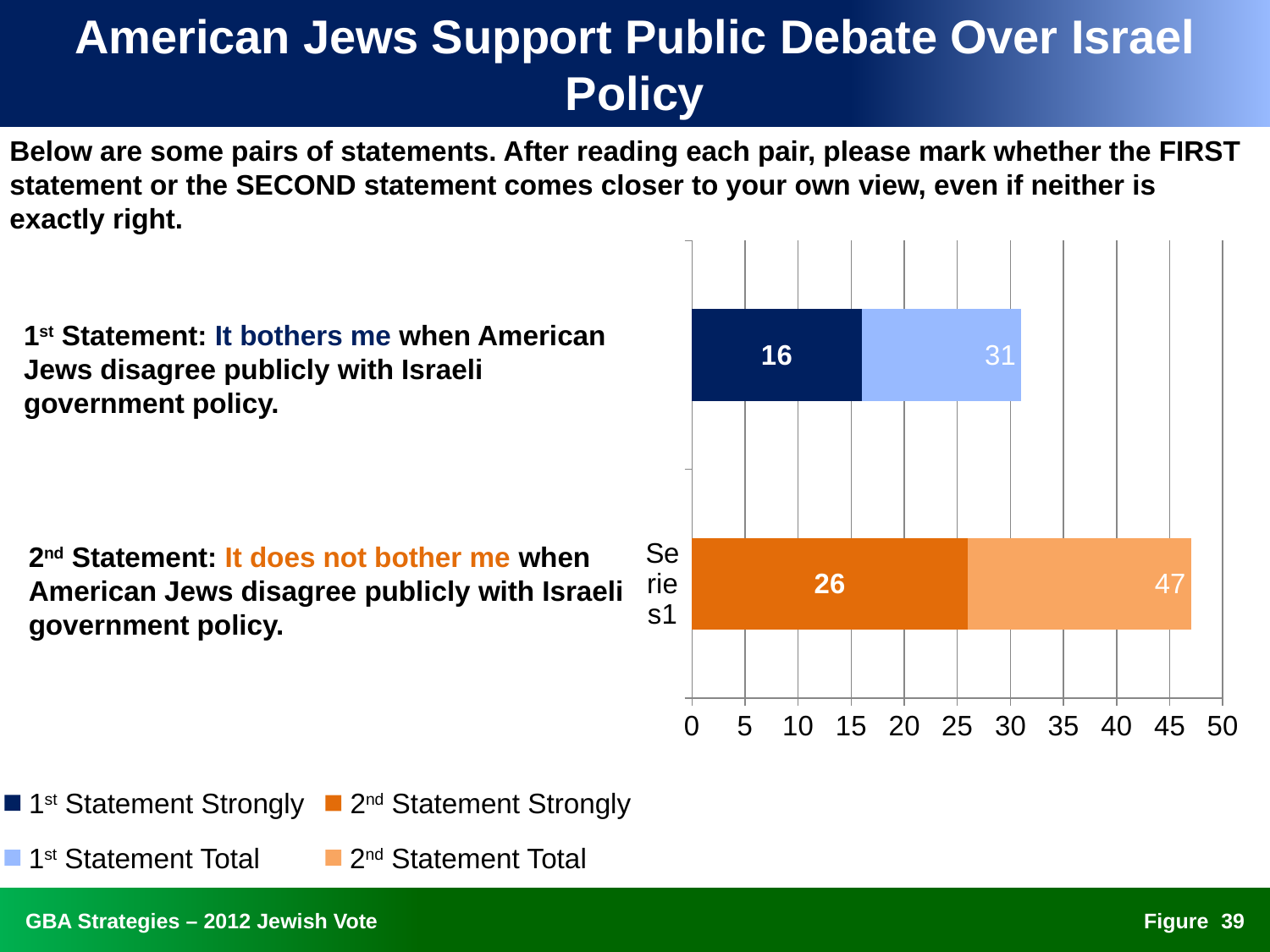
What value is shown for 2nd Statement Strongly? 26 What is the difference between the 2nd Statement Total and the 1st Statement Total? 16 What kind of chart is shown on the slide? bar chart What value is shown for 1st Statement Total? 31 How many series does the legend list? 4 Which legend series has the lowest value on the chart? 1st Statement Strongly What value is shown for 2nd Statement Total? 47 What is the highest value shown on the horizontal axis? 50 Which legend series has the highest value on the chart? 2nd Statement Total What is the difference between 2nd Statement Strongly and 1st Statement Strongly? 10 Which is larger, the 1st Statement Total or the 2nd Statement Total? 2nd Statement Total What value is shown for 1st Statement Strongly? 16